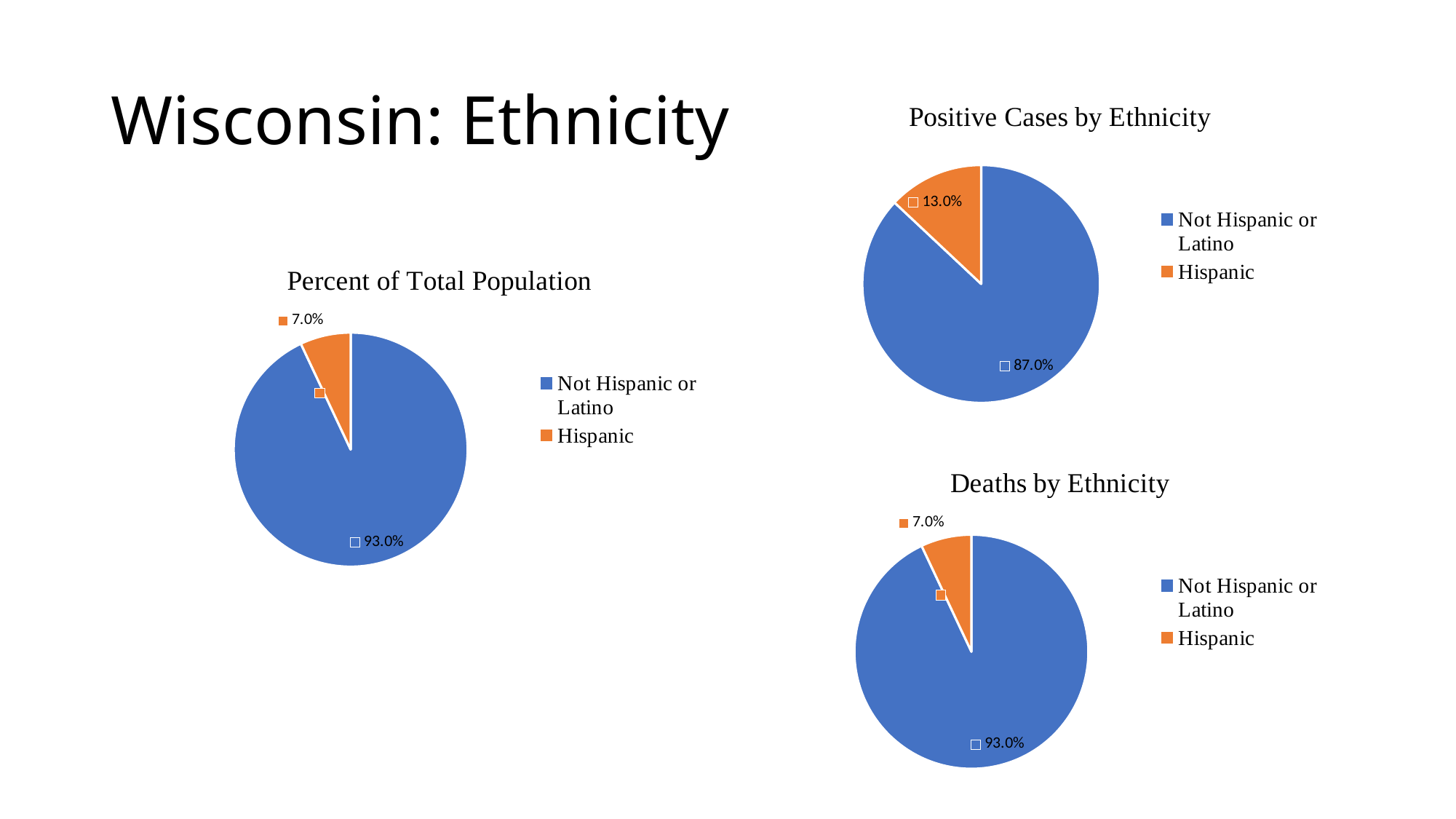
In the 'Deaths by Ethnicity' chart, what is the value for Hispanic? 7.0% In the 'Positive Cases by Ethnicity' chart, what is the difference between the Not Hispanic or Latino and Hispanic values? 74.0% In the 'Percent of Total Population' chart, what is the value for Not Hispanic or Latino? 93.0% How many categories does the legend of the 'Percent of Total Population' chart list? 2 Is the Hispanic value larger in the 'Positive Cases by Ethnicity' chart or in the 'Deaths by Ethnicity' chart? Positive Cases by Ethnicity In the 'Positive Cases by Ethnicity' chart, what is the value for Hispanic? 13.0% In the 'Percent of Total Population' chart, what share of the pie is Hispanic? 7.0% In the 'Positive Cases by Ethnicity' chart, what share of the pie is Not Hispanic or Latino? 87.0% What type of chart is 'Deaths by Ethnicity'? Pie chart In the 'Positive Cases by Ethnicity' chart, which category has the largest slice? Not Hispanic or Latino In the 'Deaths by Ethnicity' chart, which category has the smallest slice? Hispanic In the 'Deaths by Ethnicity' chart, what is the value for Not Hispanic or Latino? 93.0%